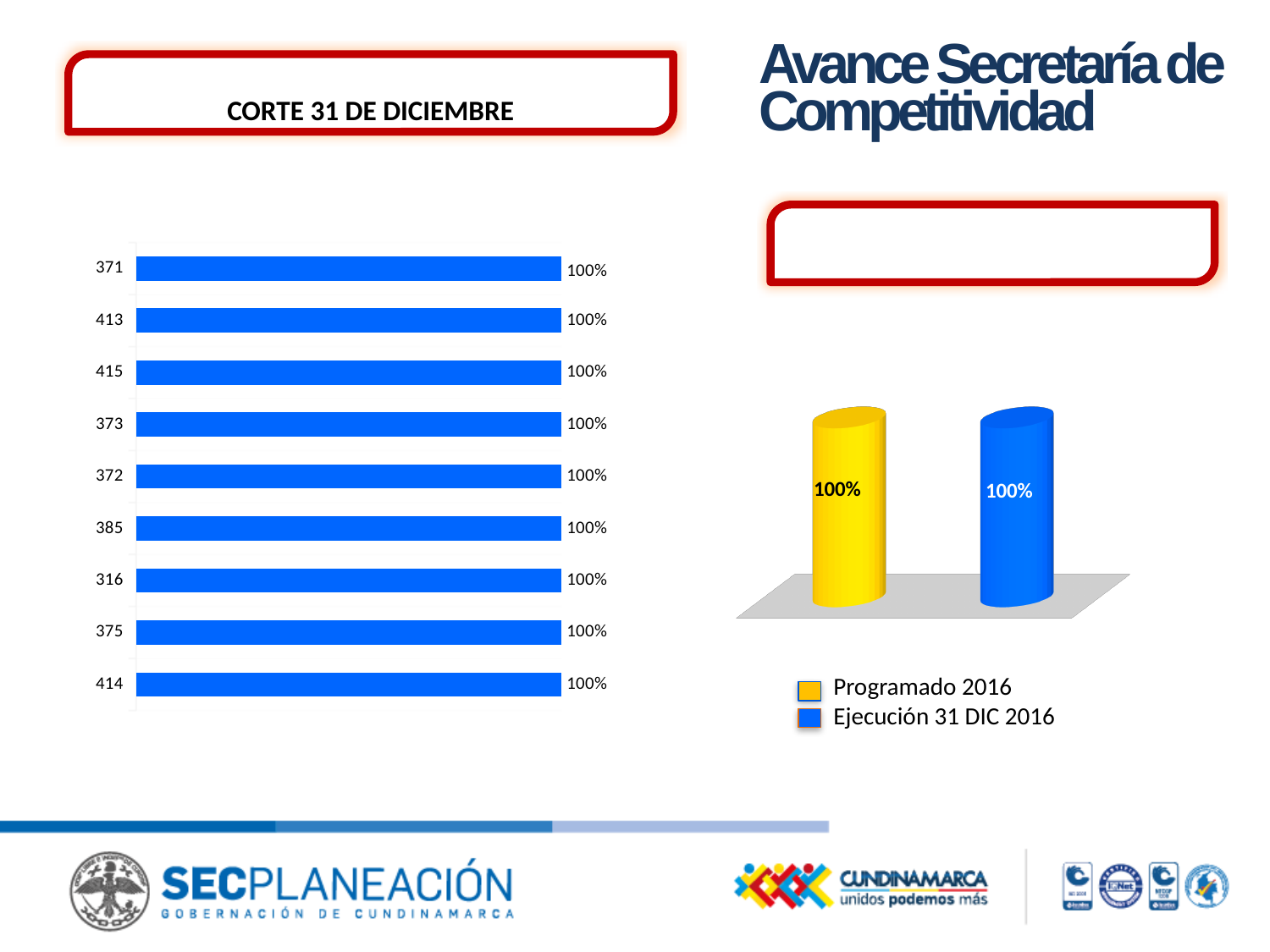
In the left chart, what is the value for category 371? 100% What kind of chart is the left chart? bar chart In the right chart, what is the value for Programado 2016? 100% In the right chart, what is the value for Ejecución 31 DIC 2016? 100% In the left chart, what is the difference between the values for category 413 and category 375? 0% In the right chart, what is the difference between Programado 2016 and Ejecución 31 DIC 2016? 0% In the right chart, what colour is the bar for Programado 2016? yellow In the left chart, what is the value for category 414? 100% In the left chart, what is the value for category 316? 100% How many categories are shown in the left chart? 9 In the left chart, which category is listed at the top of the axis? 371 How many series does the legend of the right chart list? 2